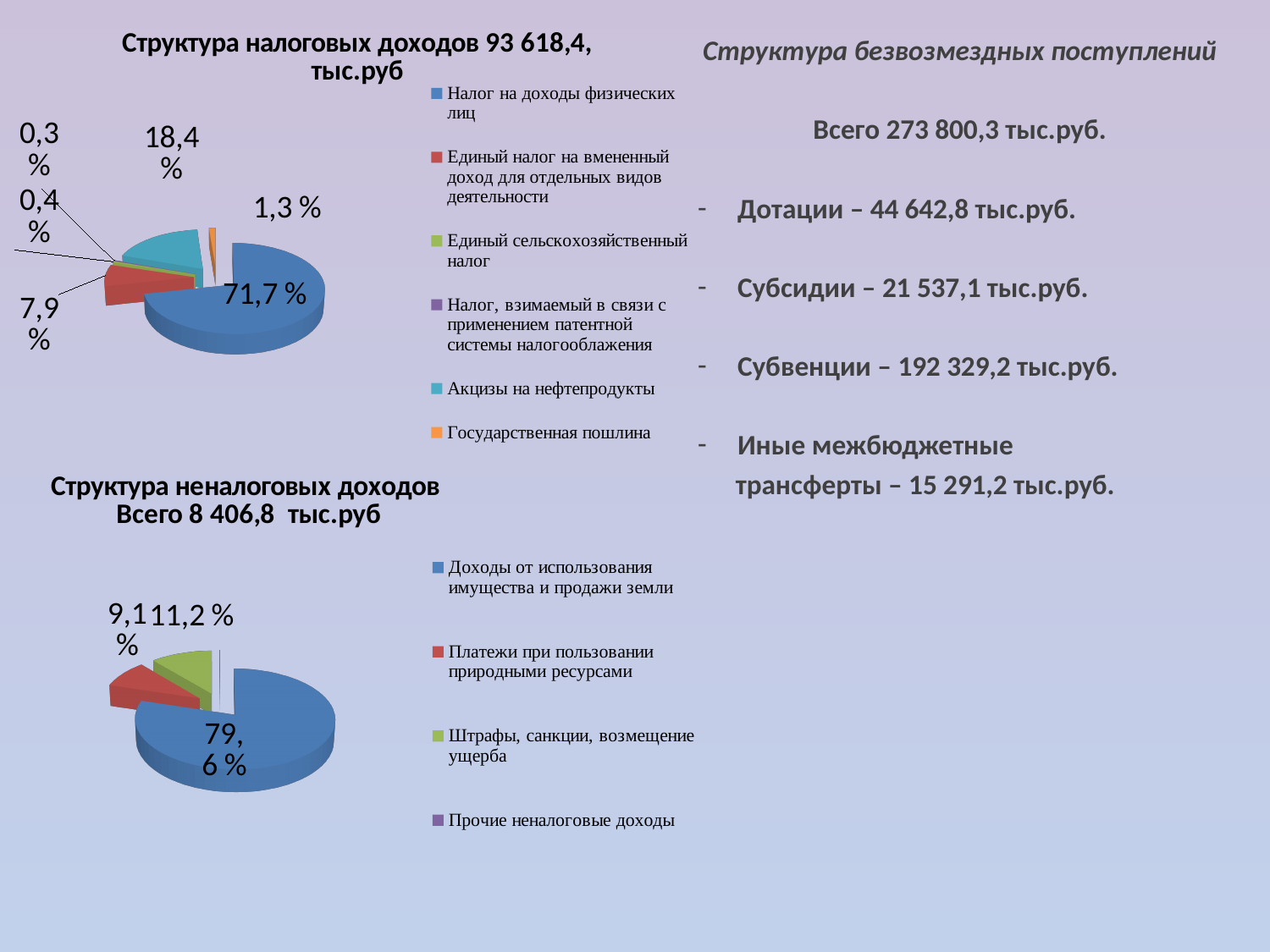
In the top pie chart (Структура налоговых доходов), how many categories does the legend list? 6 In the top pie chart (Структура налоговых доходов), what share is shown for the largest slice? 71,7 % In the top pie chart (Структура налоговых доходов), which is larger: the share of Акцизы на нефтепродукты or the share of Единый налог на вмененный доход? Акцизы на нефтепродукты What type of chart is used for Структура неналоговых доходов? Pie chart In the top pie chart (Структура налоговых доходов), what share is shown for Единый налог на вмененный доход для отдельных видов деятельности? 7,9 % In the top pie chart (Структура налоговых доходов), what is the difference between the shares of Налог на доходы физических лиц and Акцизы на нефтепродукты? 53,3 % In the top pie chart (Структура налоговых доходов), what share is shown for Государственная пошлина? 1,3 % What total amount is stated in the title of the bottom pie chart (Структура неналоговых доходов)? 8 406,8 тыс.руб In the top pie chart (Структура налоговых доходов), what share is shown for Акцизы на нефтепродукты? 18,4 % In the bottom pie chart (Структура неналоговых доходов), how many categories does the legend list? 4 In the top pie chart (Структура налоговых доходов), which legend category has the largest share? Налог на доходы физических лиц In the bottom pie chart (Структура неналоговых доходов), what share is shown for Доходы от использования имущества и продажи земли? 79,6 %